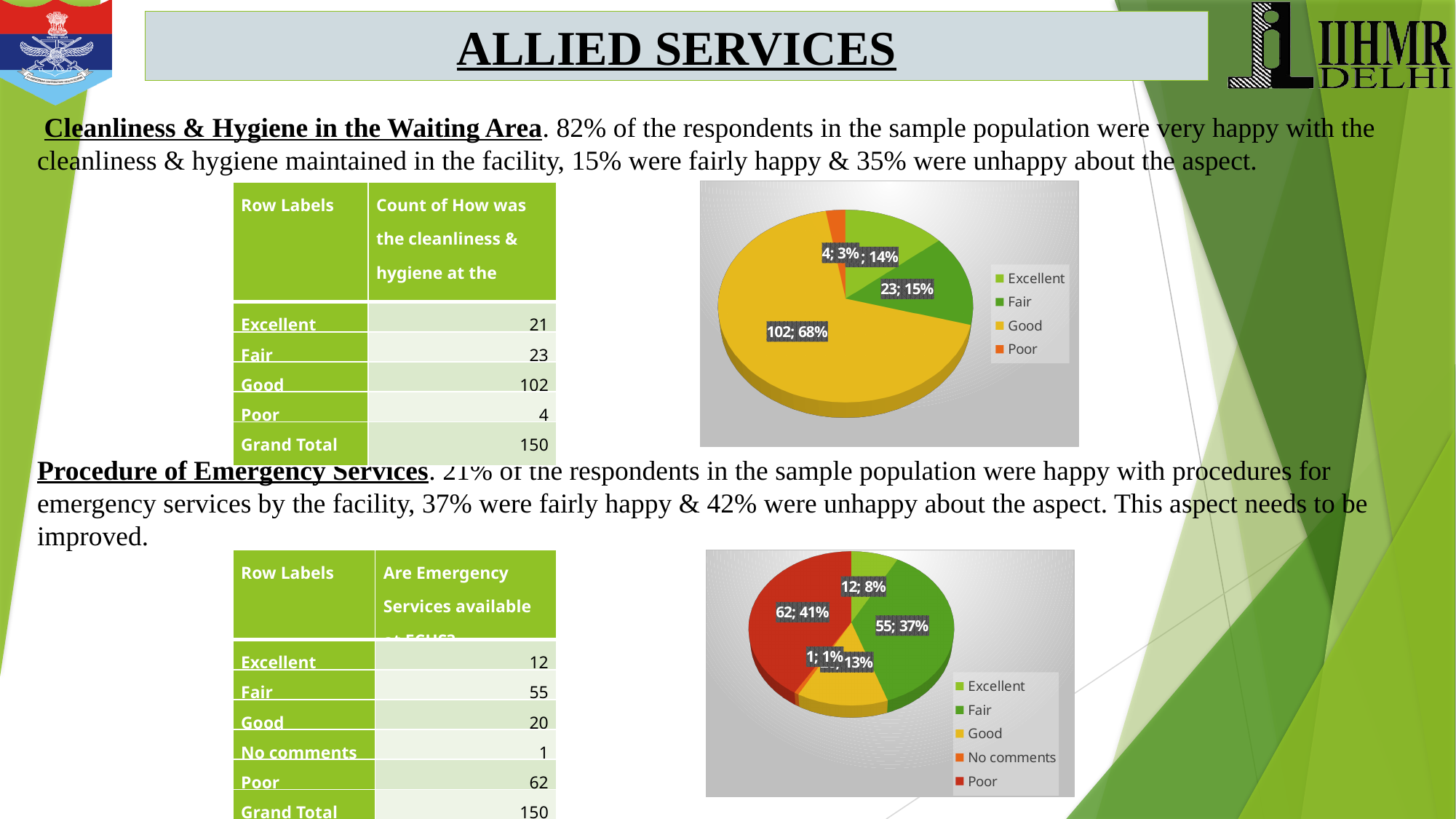
In the top pie chart, what is the value shown for Good? 102; 68% How many categories does the legend of the bottom pie chart list? 5 In the top pie chart, which category has the largest slice? Good What type of chart is the top chart on the slide? pie chart In the bottom pie chart, what is the value shown for Poor? 62; 41% In the bottom pie chart, what is the difference between the Poor count and the Fair count? 7 How many categories does the legend of the top pie chart list? 4 In the top pie chart, what share of the pie does Poor represent? 3% In the bottom pie chart, what is the value shown for Fair? 55; 37% In the top pie chart, which category has the smallest slice? Poor In the bottom pie chart, which category has the largest slice? Poor In the top pie chart, what is the value shown for Fair? 23; 15%